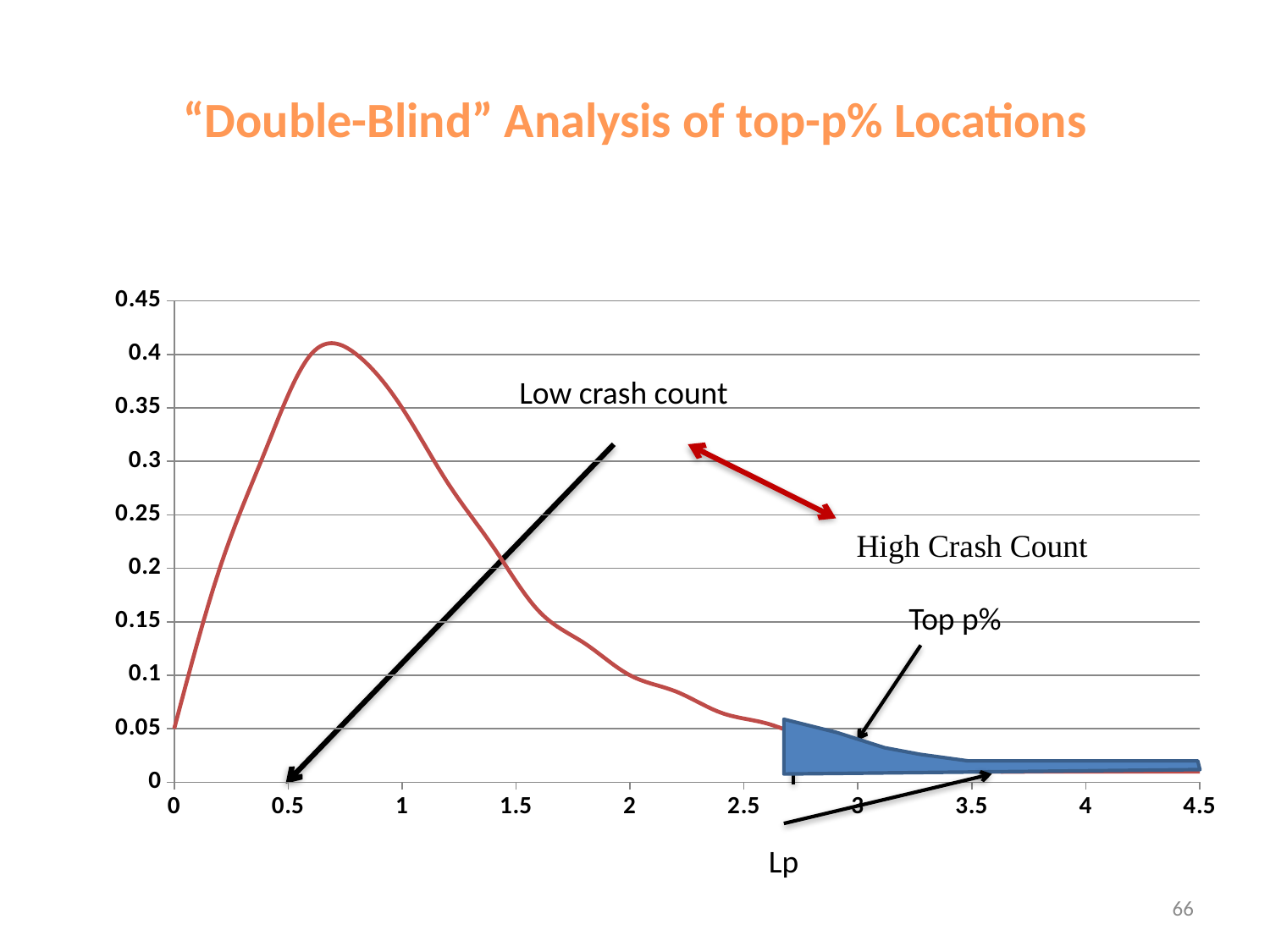
Is the value of the curve at x = 2 greater or less than 0.15? less Which is larger, the value of the curve at x = 0.5 or at x = 2? x = 0.5 What is the highest value shown on the y axis? 0.45 Is the value of the curve at x = 1.5 greater or less than 0.25? less What is the title of the slide containing the chart? "Double-Blind" Analysis of top-p% Locations What kind of chart is shown on the slide? line chart What label is attached by an arrow to the shaded blue region under the tail of the curve? Top p% Is the value of the curve at x = 1 greater or less than 0.3? greater Do the values of the curve rise or fall along the x axis between x = 0 and x = 0.5? rise Do the values of the curve rise or fall along the x axis between x = 1 and x = 2.5? fall